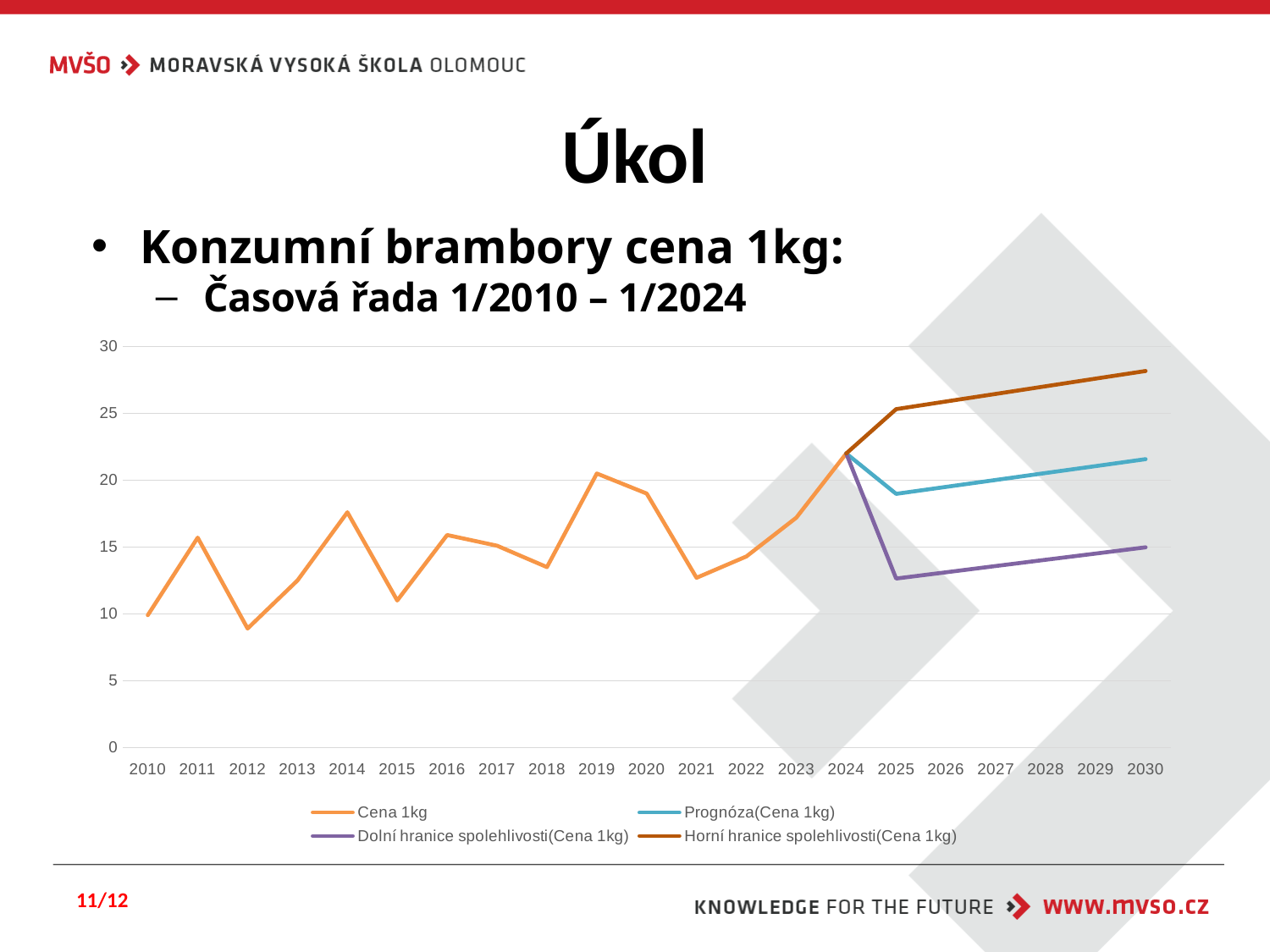
Is the value for Horní hranice spolehlivosti(Cena 1kg) in 2030 greater or less than 25? greater How many years are shown on the x axis of the chart? 21 Which is larger, the Cena 1kg value in 2019 or in 2012? 2019 Which year has the lowest value for the Cena 1kg series? 2012 Is the value for Prognóza(Cena 1kg) in 2030 greater or less than 20? greater Is the value for Cena 1kg in 2014 greater or less than 15? greater Does the Horní hranice spolehlivosti(Cena 1kg) series rise or fall from 2025 to 2030? rise What kind of chart is shown on the slide? line chart How many series does the chart legend list? 4 What colour is the Cena 1kg line in the chart? orange